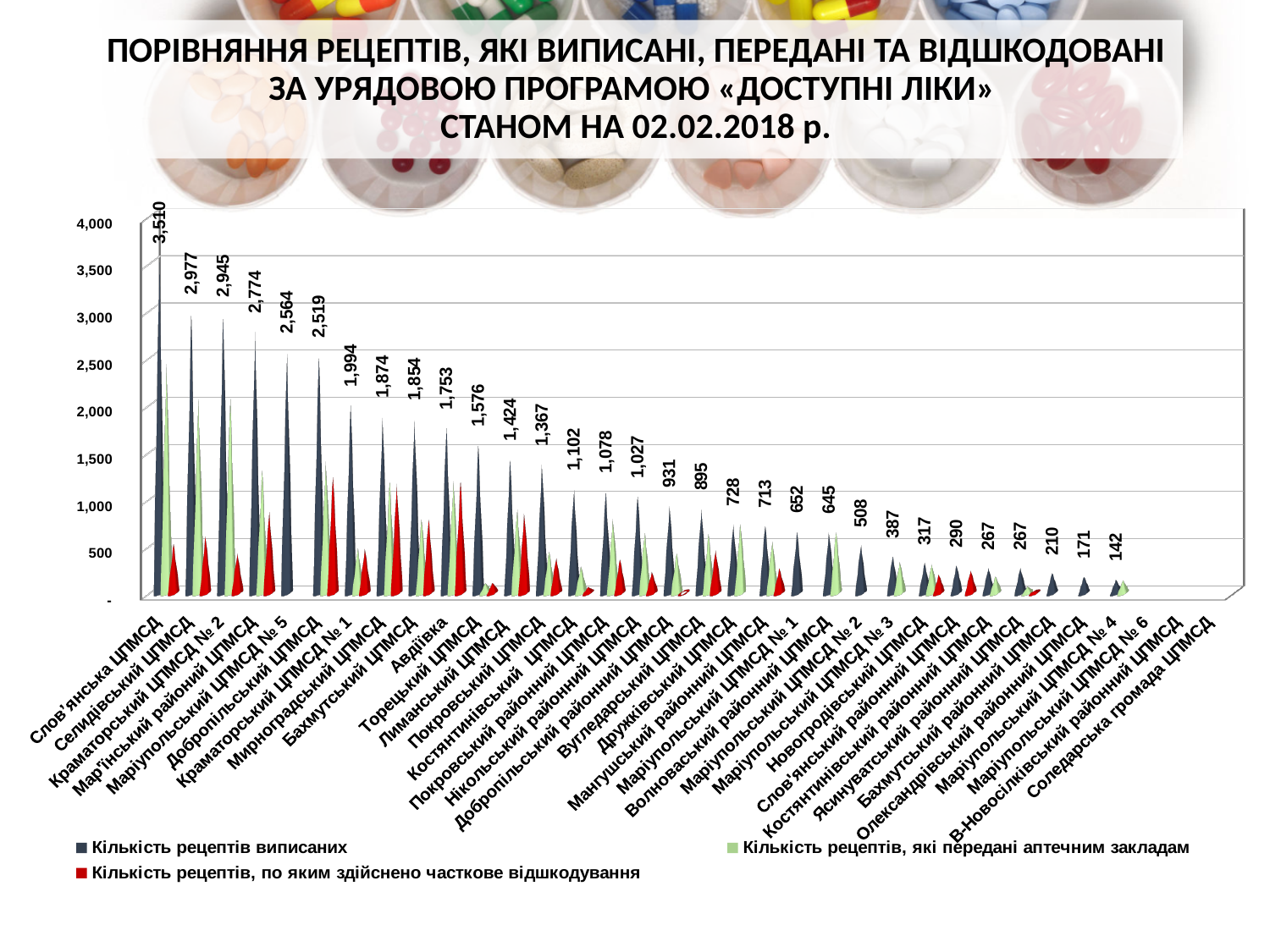
Which series is shown in red in the legend? Кількість рецептів, по яким здійснено часткове відшкодування What is the lowest data label shown for prescriptions written? 142 What is the highest value shown for prescriptions written? 3,510 Which category has the highest number of prescriptions written? Слов'янська ЦПМСД What is the number of prescriptions written (Кількість рецептів виписаних) for Слов'янська ЦПМСД? 3,510 What kind of chart is shown on the slide? bar chart Which is larger: the number of prescriptions written for Слов'янська ЦПМСД or for Селидівський ЦПМСД? Слов'янська ЦПМСД Do the values for prescriptions written rise or fall from left to right along the x axis? fall As of what date is the data on the slide reported, according to the title? 02.02.2018 Is the number of prescriptions written for Слов'янська ЦПМСД greater or less than 3,000? greater What is the difference between the two highest values for prescriptions written, 3,510 and 2,977? 533 How many series does the legend list? 3